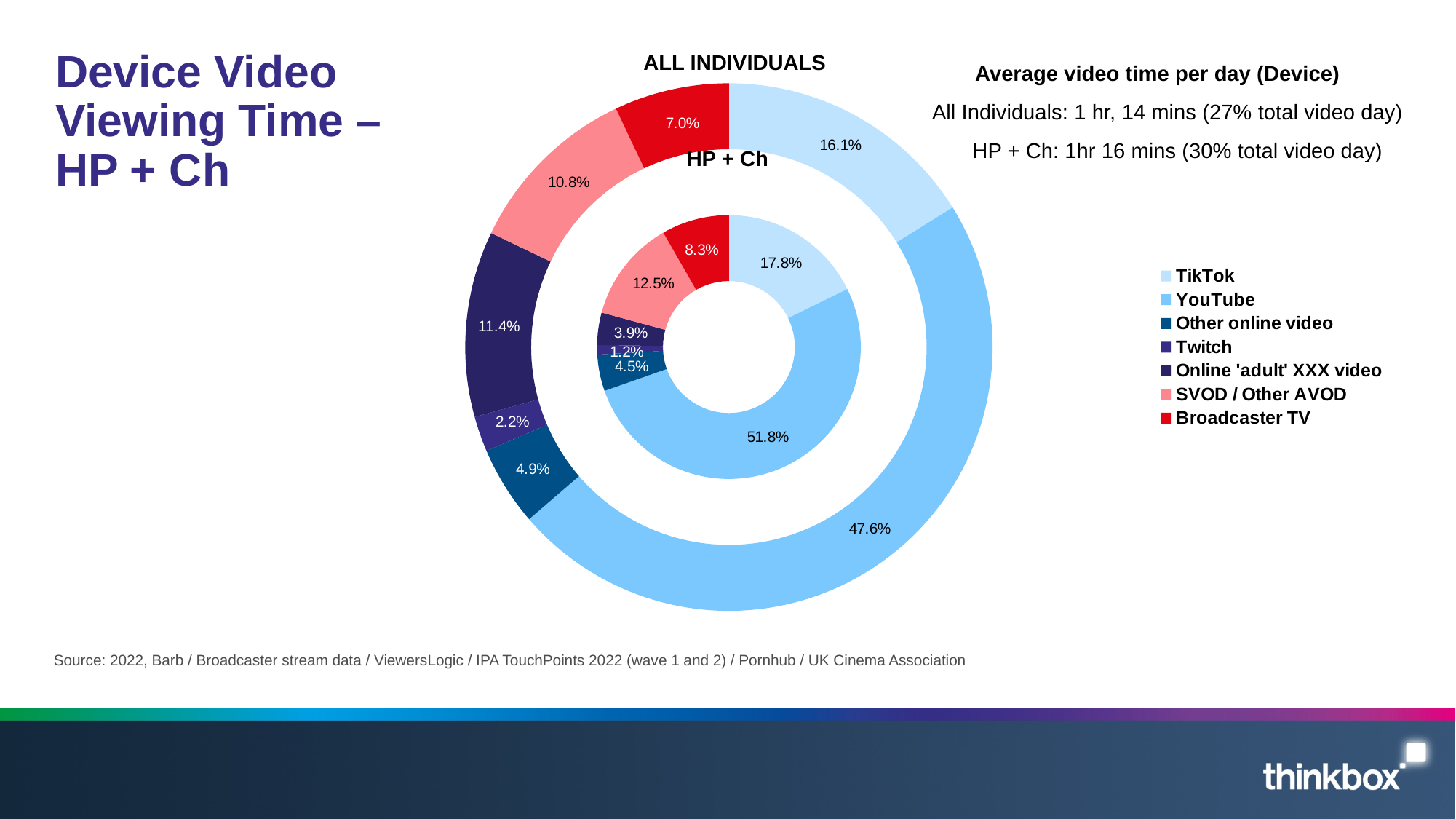
In the ALL INDIVIDUALS ring, what share does Online 'adult' XXX video have? 11.4% Which is larger: the SVOD / Other AVOD share for ALL INDIVIDUALS or for HP + Ch? HP + Ch What kind of chart is shown on the slide? Doughnut chart Which category has the largest share in the HP + Ch ring? YouTube Which category has the smallest share in the ALL INDIVIDUALS ring? Twitch In the ALL INDIVIDUALS ring, what share does YouTube have? 47.6% In the ALL INDIVIDUALS ring, what share does Other online video have? 4.9% In the HP + Ch ring, what share does Broadcaster TV have? 8.3% What is the difference between the YouTube share in the HP + Ch ring and in the ALL INDIVIDUALS ring? 4.2% How many categories does the legend list? 7 In the HP + Ch ring, what share does TikTok have? 17.8% Which ring of the doughnut chart represents ALL INDIVIDUALS, the outer or the inner? Outer